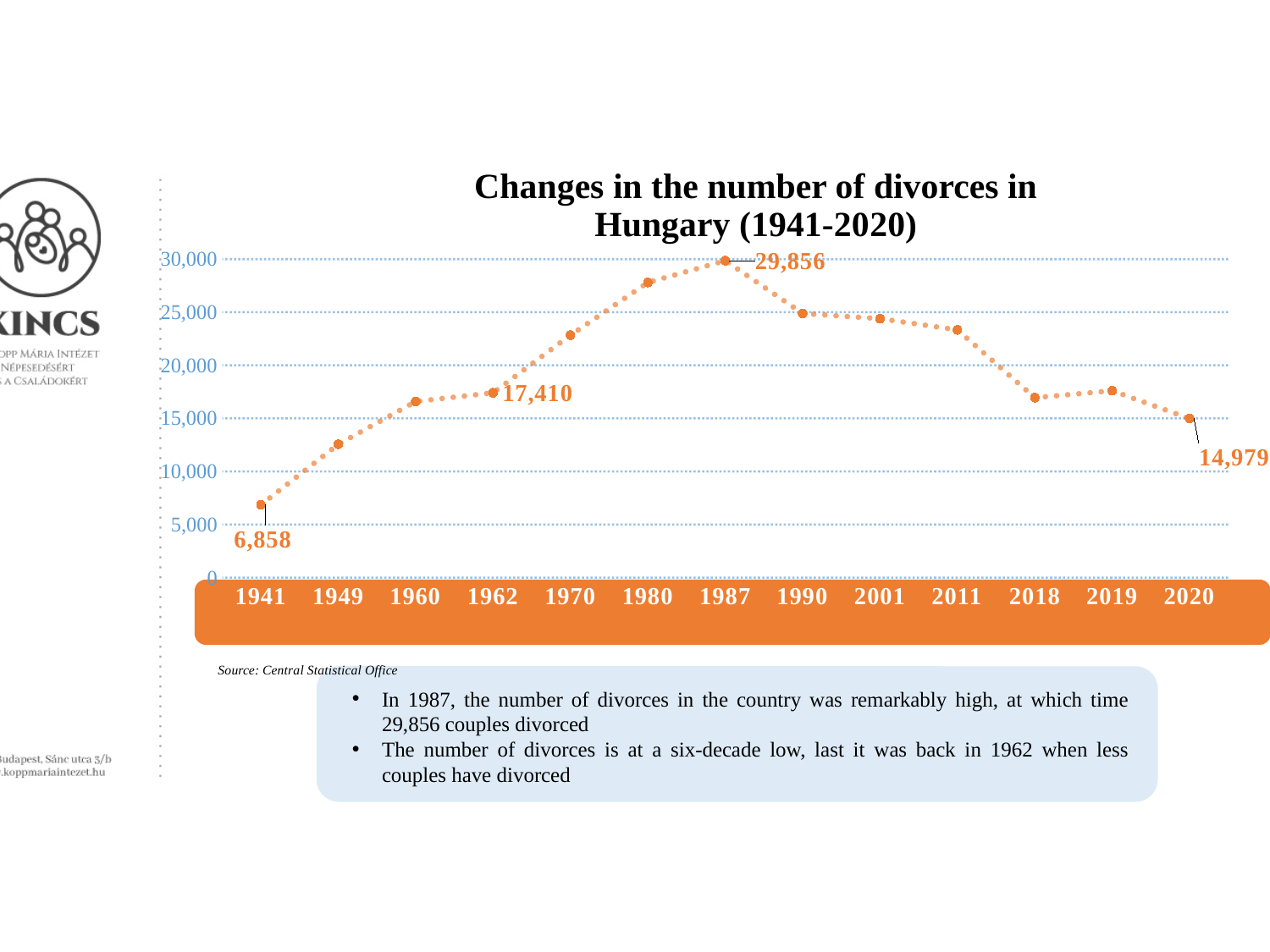
What was the number of divorces in Hungary in 1987? 29,856 Is the value for 1980 greater or less than 25,000? greater Which year had more divorces, 1962 or 2020? 1962 Is the value for 1949 greater or less than 15,000? less What was the number of divorces in Hungary in 2020? 14,979 In which year was the number of divorces lowest? 1941 How much higher was the number of divorces in 1987 than in 2020? 14,877 What kind of chart is shown on the slide? Line chart In which year was the number of divorces highest? 1987 How many years are plotted on the x axis? 13 What was the number of divorces in Hungary in 1962? 17,410 What was the number of divorces in Hungary in 1941? 6,858